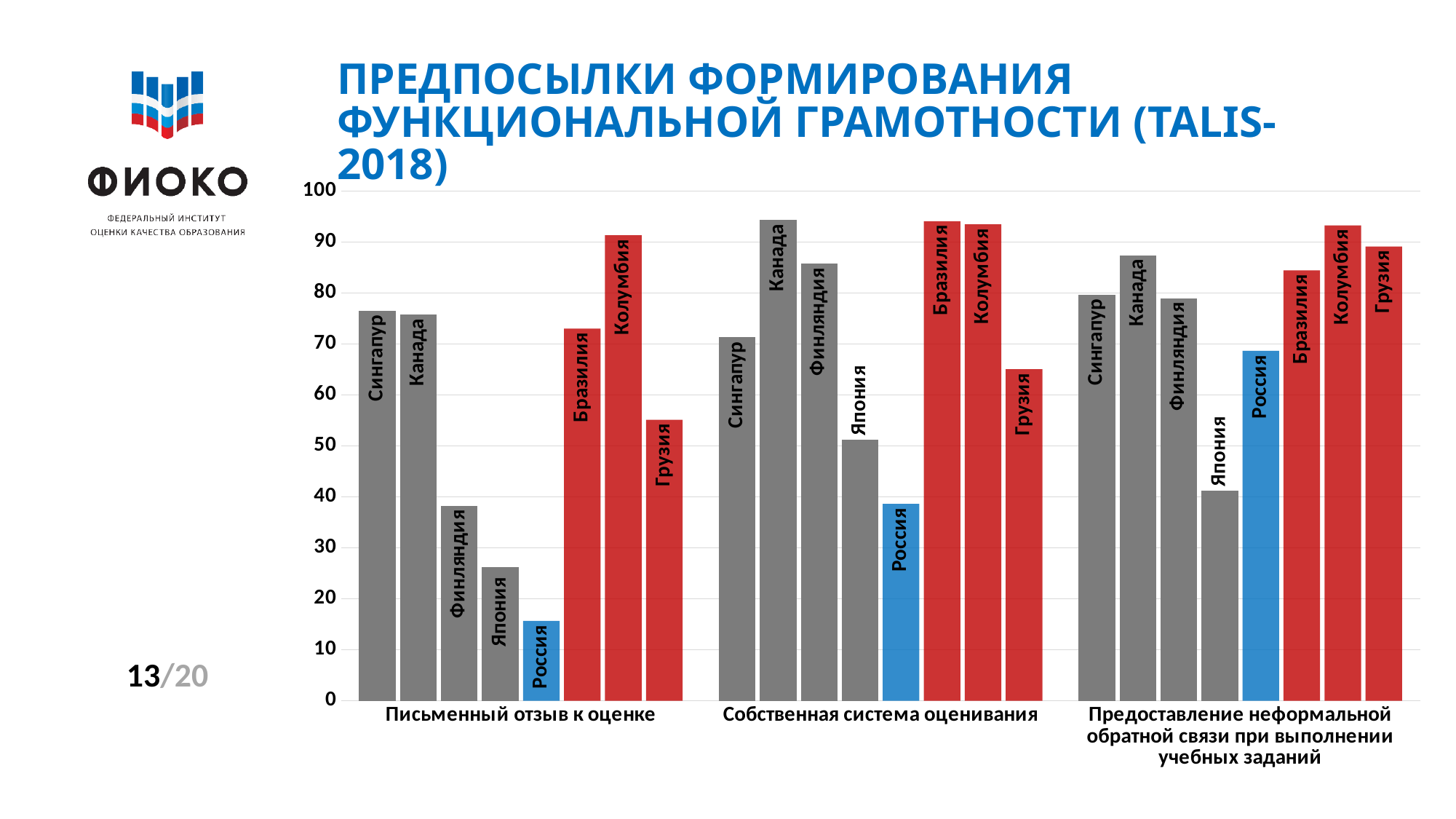
In the group "Собственная система оценивания", which country has the lowest bar? Россия Is the value for Россия in the group "Письменный отзыв к оценке" greater or less than 20? less How many category groups are shown along the x axis of the chart? 3 In the group "Предоставление неформальной обратной связи при выполнении учебных заданий", which country has the lowest bar? Япония In the group "Письменный отзыв к оценке", which country has the lowest bar? Россия What colour are the bars for Россия in the chart? Blue What kind of chart is shown on the slide? Bar chart In the group "Письменный отзыв к оценке", which is larger: the value for Финляндия or the value for Япония? Финляндия In the group "Письменный отзыв к оценке", which country has the highest bar? Колумбия Is the value for Япония in the group "Собственная система оценивания" greater or less than 60? less How many countries (bars) are shown in each category group? 8 Is the value for Россия in the group "Предоставление неформальной обратной связи при выполнении учебных заданий" greater or less than 60? greater